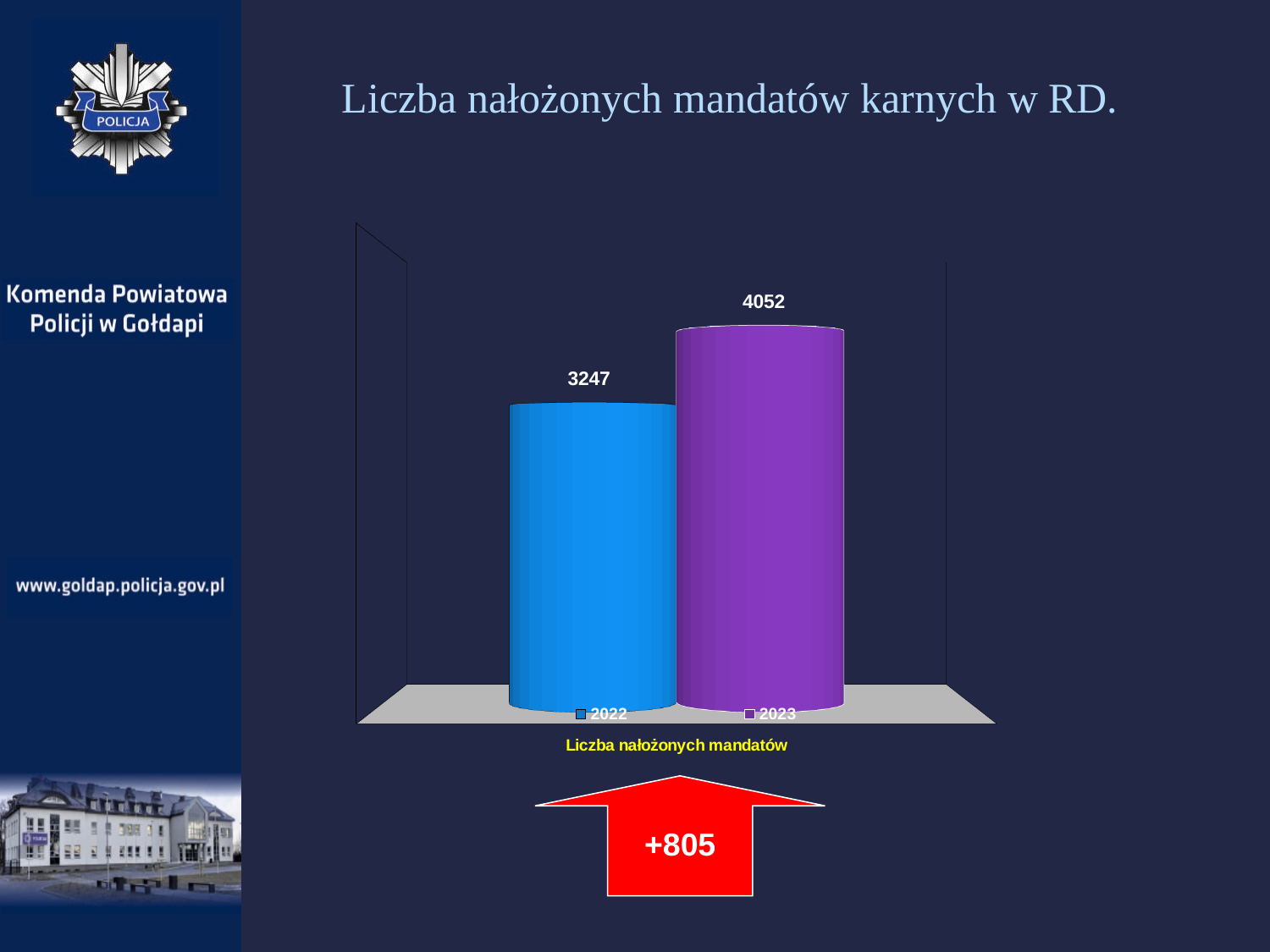
What is the title of the chart on the slide? Liczba nałożonych mandatów karnych w RD. What is the difference between the 2023 and 2022 values in the chart? 805 What kind of chart is shown on the slide? bar chart What is the value for 2022 in the chart? 3247 How many bars are plotted in the chart? 2 Do the values rise or fall from 2022 to 2023? rise Which year has the higher number of fines (mandatów) in the chart? 2023 Is the value for 2023 larger or smaller than the value for 2022? larger Which year has the lower number of fines in the chart? 2022 How many series does the chart legend list? 2 What is the value for 2023 in the chart? 4052 What colour is the bar for 2023 in the chart? purple